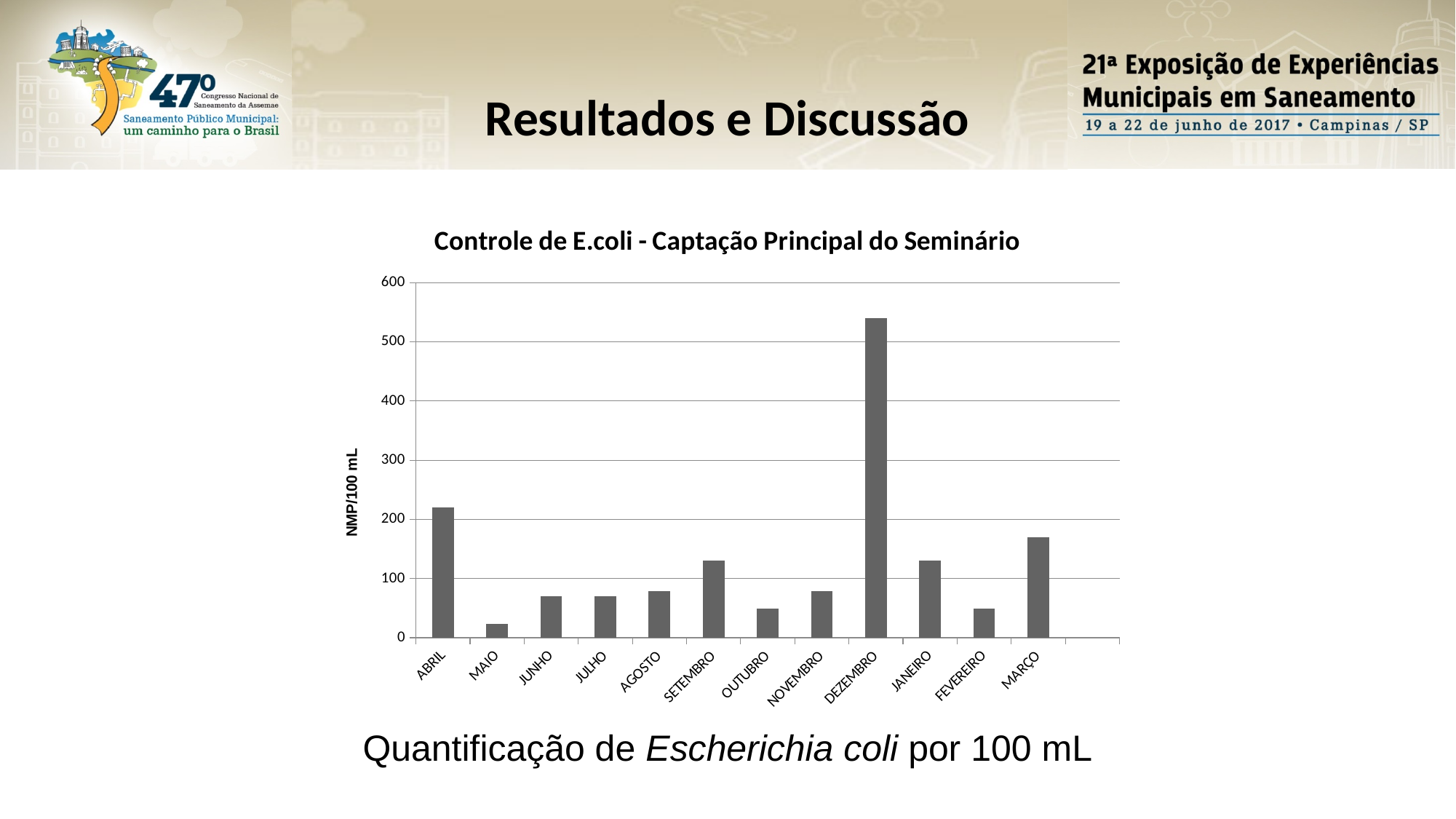
What type of chart is shown on the slide? bar chart What is the title of the chart? Controle de E.coli - Captação Principal do Seminário Which is larger, the value for SETEMBRO or the value for JUNHO? SETEMBRO Is the value for MARÇO greater or less than 200? less Is the value for MAIO greater or less than 100? less How many months are plotted on the x axis? 12 Which month has the lowest value? MAIO Is the value for DEZEMBRO greater or less than 500? greater What is the label of the vertical axis? NMP/100 mL Which is larger, the value for ABRIL or the value for MARÇO? ABRIL Which month has the highest value? DEZEMBRO